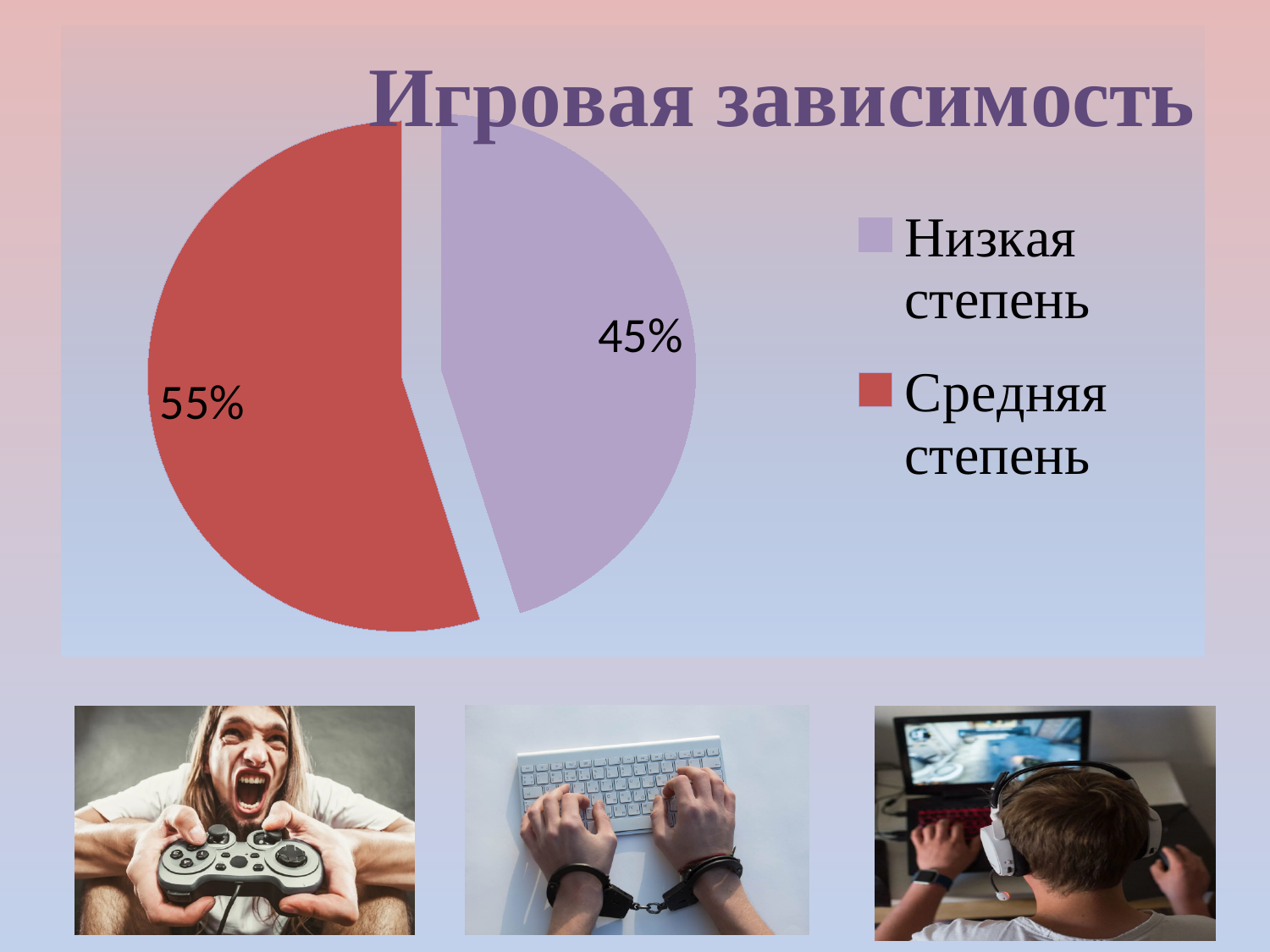
How many slices does the pie chart have? 2 What is the value for Средняя степень? 55% What is the value for Низкая степень? 45% What type of chart is shown on the slide? pie chart What is the title of the chart? Игровая зависимость Which category has the smallest share of the pie? Низкая степень Which category has the largest share of the pie? Средняя степень What share of the pie does Низкая степень take? 45% Which is larger, the share for Низкая степень or the share for Средняя степень? Средняя степень What is the difference between the shares of Средняя степень and Низкая степень? 10% What colour is the slice for Средняя степень? red How many entries does the legend list? 2